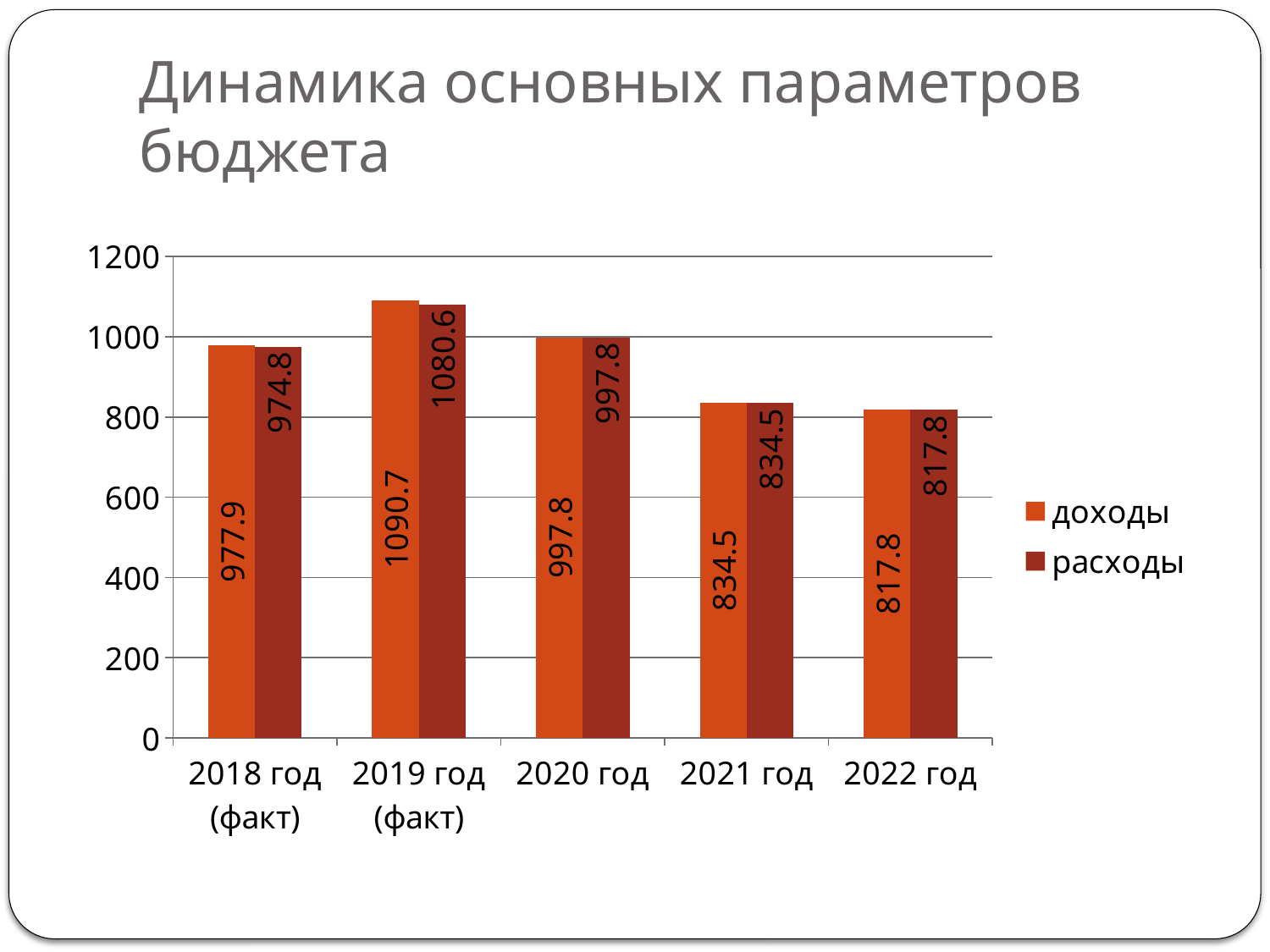
Which is larger in 2018 год (факт): доходы or расходы? доходы What is the value of доходы for 2019 год (факт)? 1090.7 What is the difference between доходы in 2018 год (факт) and доходы in 2021 год? 143.4 Which year has the lowest расходы value? 2022 год What is the value of расходы for 2022 год? 817.8 Is the value of доходы for 2020 год greater or less than 1000? less How many series does the legend list? 2 Which year has the highest доходы value? 2019 год (факт) What is the difference between доходы and расходы in 2019 год (факт)? 10.1 What kind of chart is shown on the slide? bar chart How many years are shown on the x axis? 5 What is the value of расходы for 2018 год (факт)? 974.8